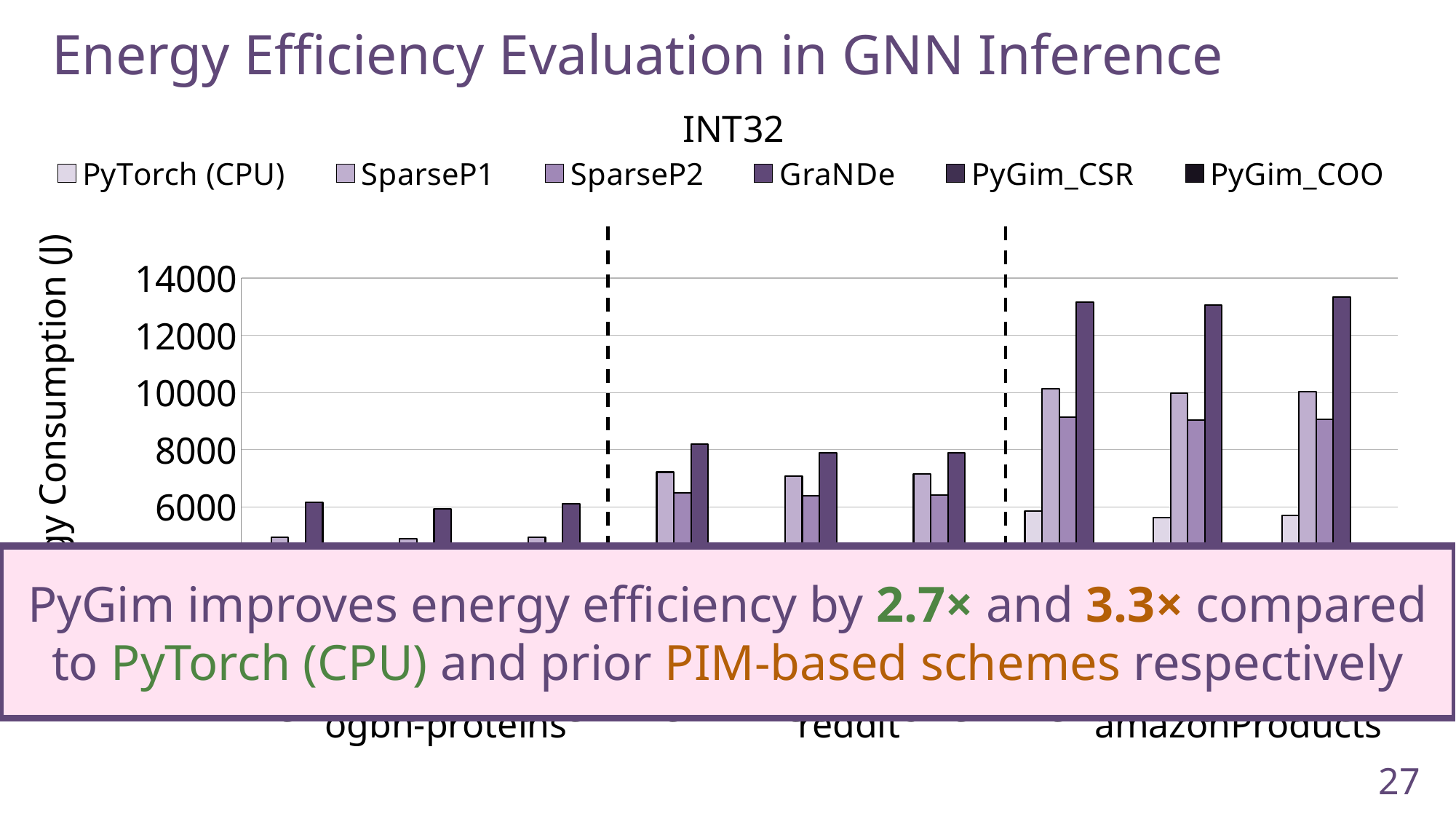
Is the value of the SparseP1 bar in the first amazonProducts group greater or less than 8000? greater Do the visible energy consumption values generally rise or fall moving from ogbn-proteins to amazonProducts along the x axis? rise Is the value of the SparseP1 bar in the first ogbn-proteins group greater or less than 6000? less In the first amazonProducts group, which is larger: the GraNDe bar or the SparseP1 bar? GraNDe How many dataset categories are labeled on the x axis of the chart? 3 What kind of chart is shown on the slide? bar chart What is the title shown above the chart legend? INT32 How many series does the chart legend list? 6 Among the visible bars, which dataset on the x axis has the highest energy consumption values? amazonProducts Is the value of the GraNDe bar in the first reddit group greater or less than 10000? less What is the label of the y axis of the chart? Energy Consumption (J)